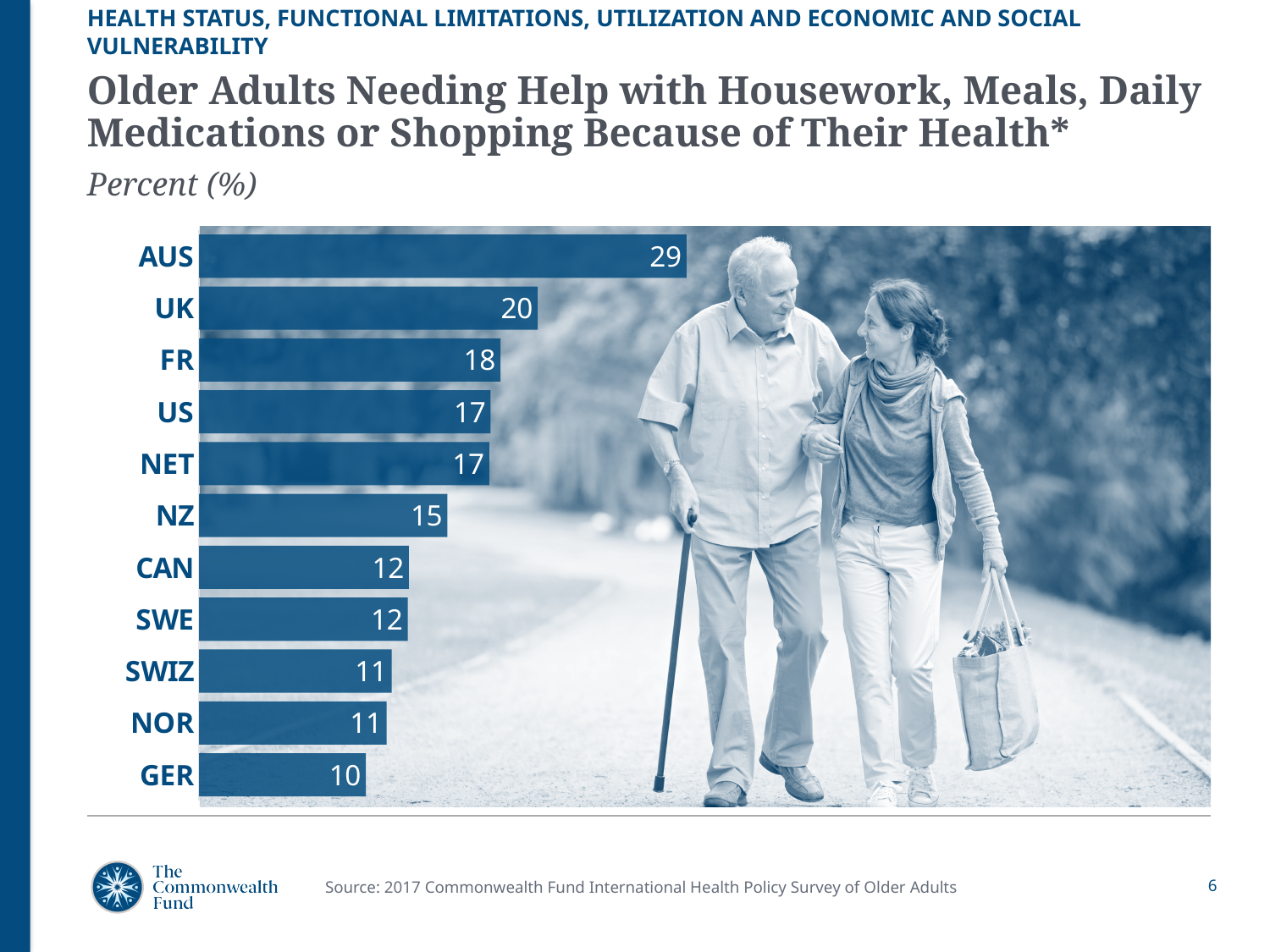
How many countries are shown in the chart? 11 Which is larger, the value for UK or the value for US? UK What is the difference between the values for FR and CAN? 6 What is the value for SWIZ? 11 Which country has the lowest value? GER What is the value for GER? 10 What is the difference between the values for AUS and UK? 9 What unit are the values in the chart expressed in? Percent (%) What kind of chart is shown on the slide? bar chart What is the value for AUS? 29 Which country has the highest value? AUS What is the value for NZ? 15